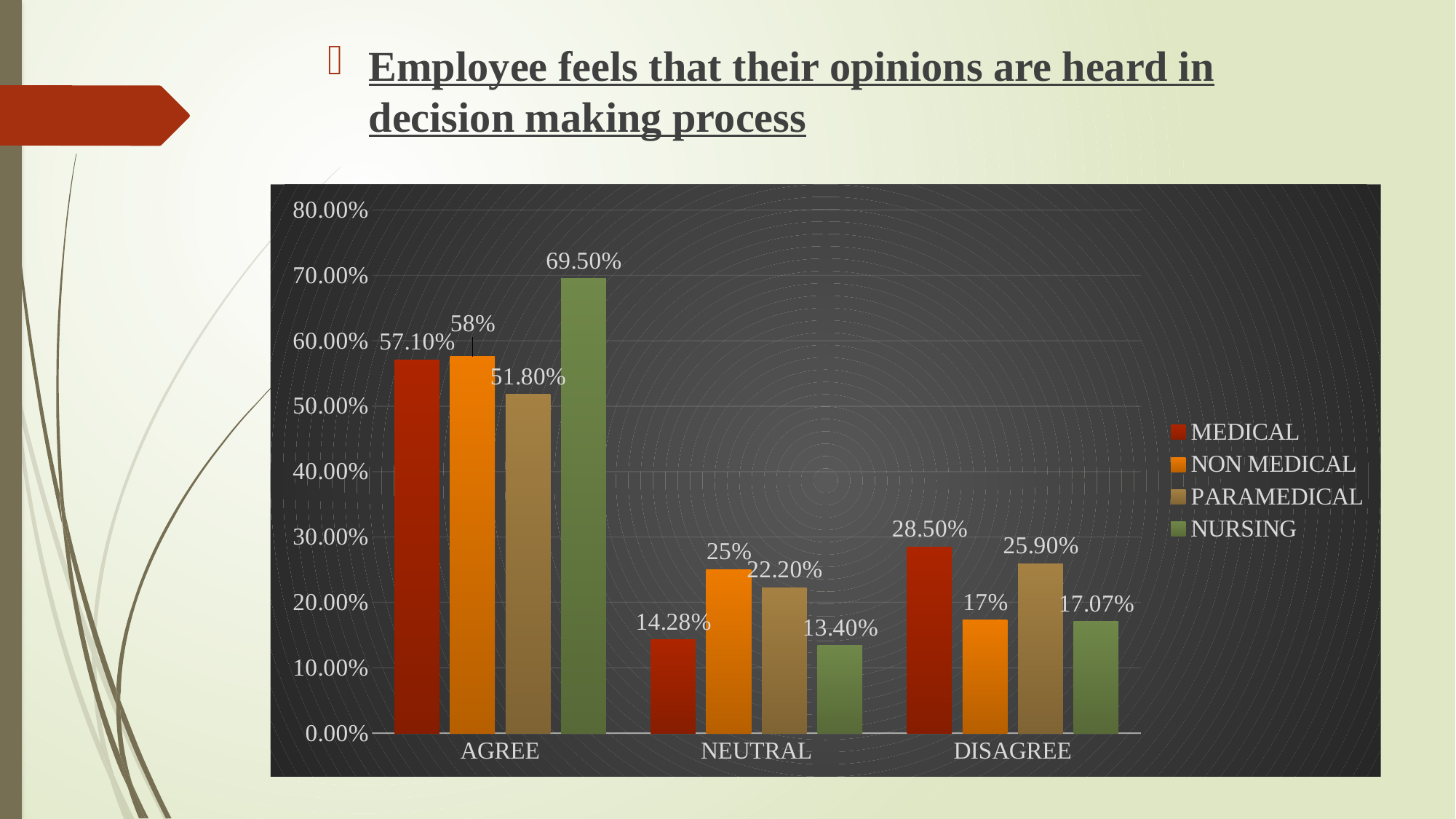
What is the value for MEDICAL in the NEUTRAL category? 14.28% What is the value for NON MEDICAL in the AGREE category? 58% How many series does the legend list? 4 Which is larger in the DISAGREE category: MEDICAL or NON MEDICAL? MEDICAL Which series has the highest value in the AGREE category? NURSING What is the difference between the NURSING and PARAMEDICAL values in the AGREE category? 17.70% What is the value for PARAMEDICAL in the DISAGREE category? 25.90% How many categories are shown on the x axis? 3 Which series is shown in green in the legend? NURSING Which series has the lowest value in the NEUTRAL category? NURSING What kind of chart is shown on the slide? Bar chart What is the value for NURSING in the AGREE category? 69.50%